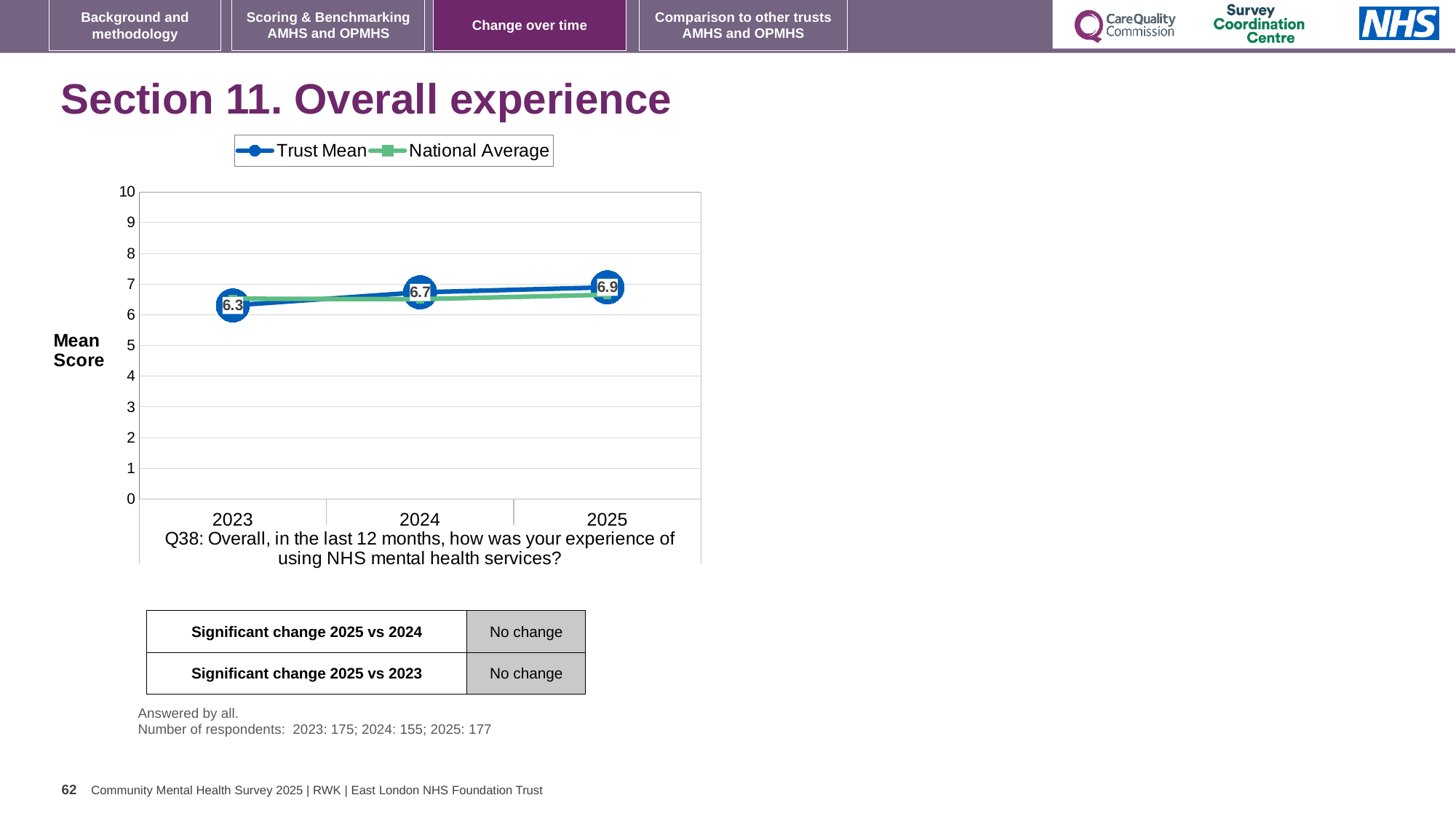
How many years are shown on the x axis of the chart? 3 In which year is the Trust Mean lowest? 2023 What is the Trust Mean value for 2023? 6.3 What is the Trust Mean value for 2025? 6.9 What is the difference between the Trust Mean in 2024 and in 2023? 0.4 Which is larger, the Trust Mean in 2025 or the Trust Mean in 2023? 2025 What is the Trust Mean value for 2024? 6.7 How many series does the chart legend list? 2 What kind of chart is shown on the slide? line chart Is the National Average value for 2025 greater or less than 5? greater What is the difference between the Trust Mean in 2025 and in 2023? 0.6 In which year is the Trust Mean highest? 2025